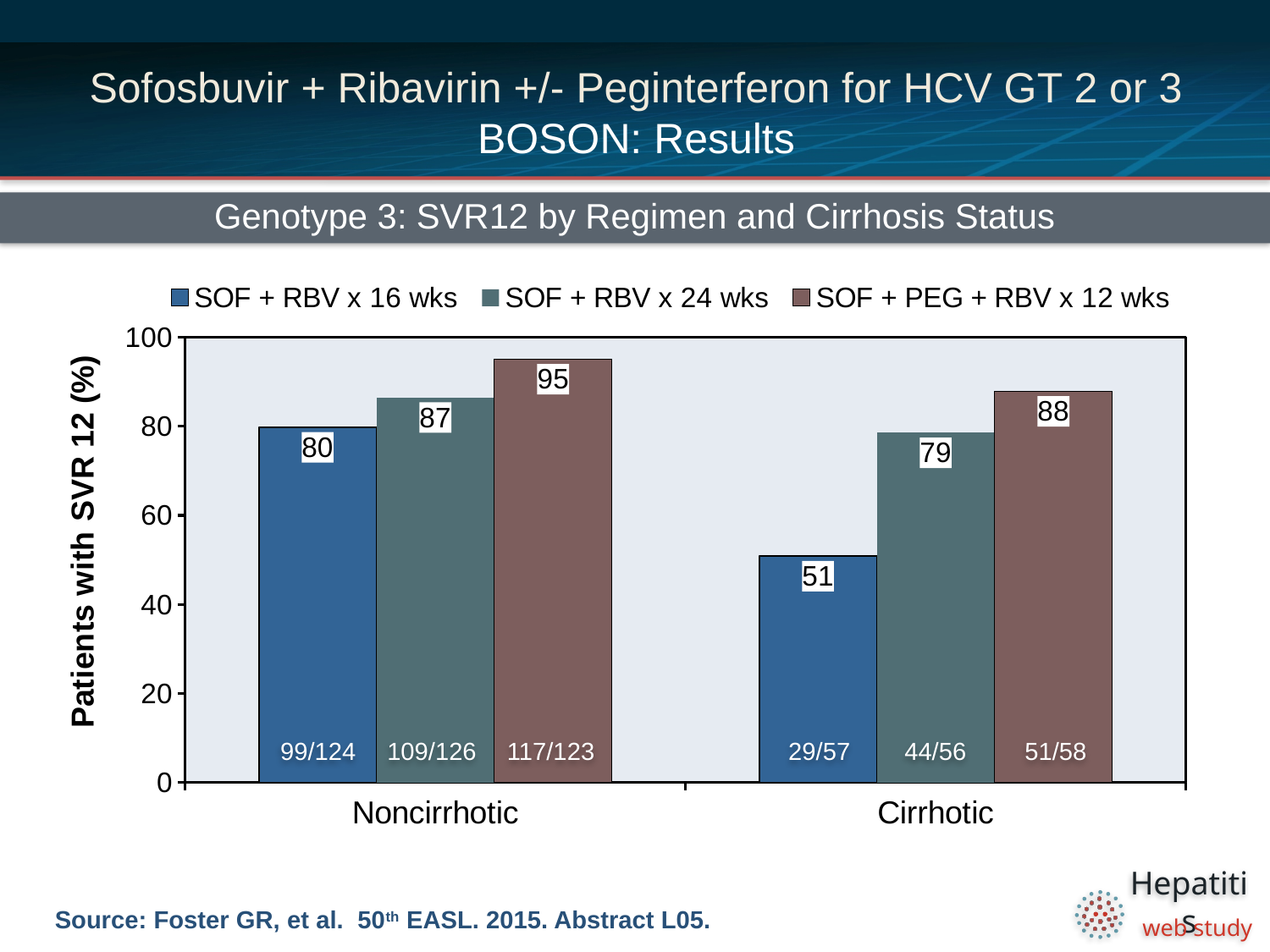
Which is larger: the SVR12 rate for SOF + RBV x 24 wks in the Noncirrhotic group or in the Cirrhotic group? Noncirrhotic Which regimen has the lowest SVR12 rate in the Cirrhotic group? SOF + RBV x 16 wks Which regimen has the highest SVR12 rate in the Noncirrhotic group? SOF + PEG + RBV x 12 wks Is the SVR12 rate for SOF + RBV x 16 wks in the Cirrhotic group greater or less than 60? less What is the SVR12 rate for SOF + RBV x 16 wks in the Noncirrhotic group? 80 How many series does the legend list? 3 What is the difference in SVR12 rate between SOF + PEG + RBV x 12 wks and SOF + RBV x 24 wks in the Noncirrhotic group? 8 What kind of chart is shown on the slide? Bar chart What is the SVR12 rate for SOF + PEG + RBV x 12 wks in the Cirrhotic group? 88 How many patient groups (categories) are shown on the x axis? 2 What is the difference in SVR12 rate between the Noncirrhotic and Cirrhotic groups for SOF + RBV x 16 wks? 29 What is the SVR12 rate for SOF + RBV x 24 wks in the Cirrhotic group? 79